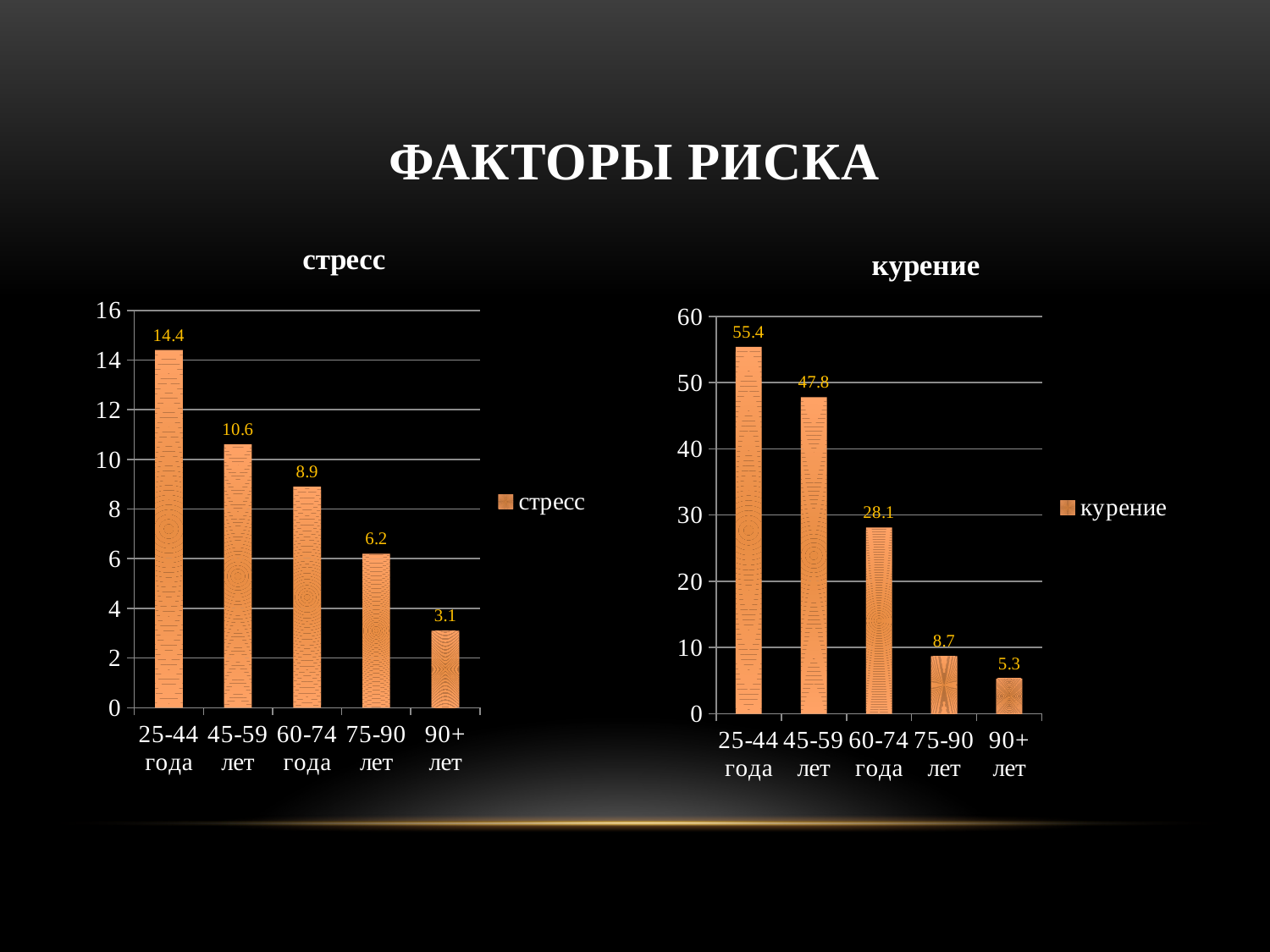
In the 'стресс' chart, what is the difference between the values for 45-59 лет and 60-74 года? 1.7 What kind of chart is the 'курение' chart? bar chart In the 'стресс' chart, what is the value for 25-44 года? 14.4 In the 'курение' chart, what is the value for 90+ лет? 5.3 In the 'стресс' chart, which is larger: the value for 75-90 лет or the value for 90+ лет? 75-90 лет In the 'стресс' chart, which age group has the lowest value? 90+ лет In the 'курение' chart, do the values rise or fall from left to right along the x axis? fall In the 'курение' chart, what is the difference between the values for 25-44 года and 45-59 лет? 7.6 In the 'курение' chart, what is the value for 60-74 года? 28.1 In the 'курение' chart, is the value for 60-74 года greater or less than 30? less How many age groups are shown in the 'стресс' chart? 5 In the 'курение' chart, which age group has the highest value? 25-44 года